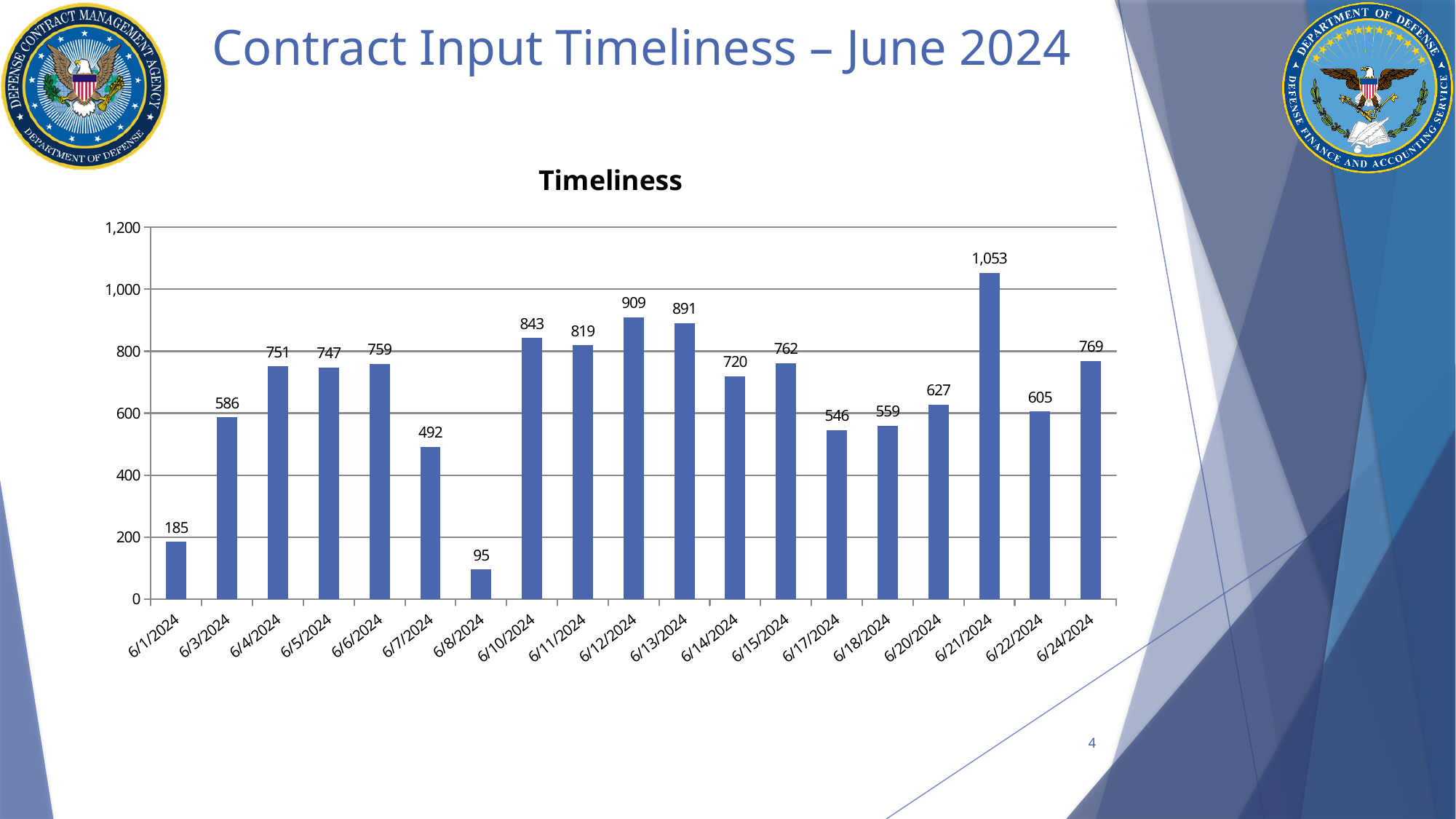
What is the difference between the values for 6/21/2024 and 6/22/2024? 448 What kind of chart is this? Bar chart What is the value for 6/17/2024? 546 What is the value for 6/21/2024? 1,053 Which date has the highest value? 6/21/2024 Which is larger, the value for 6/13/2024 or the value for 6/14/2024? 6/13/2024 How many dates are shown on the x axis? 19 What is the value for 6/12/2024? 909 What is the value for 6/8/2024? 95 What is the difference between the values for 6/10/2024 and 6/7/2024? 351 What is the title of the chart? Timeliness Which date has the lowest value? 6/8/2024